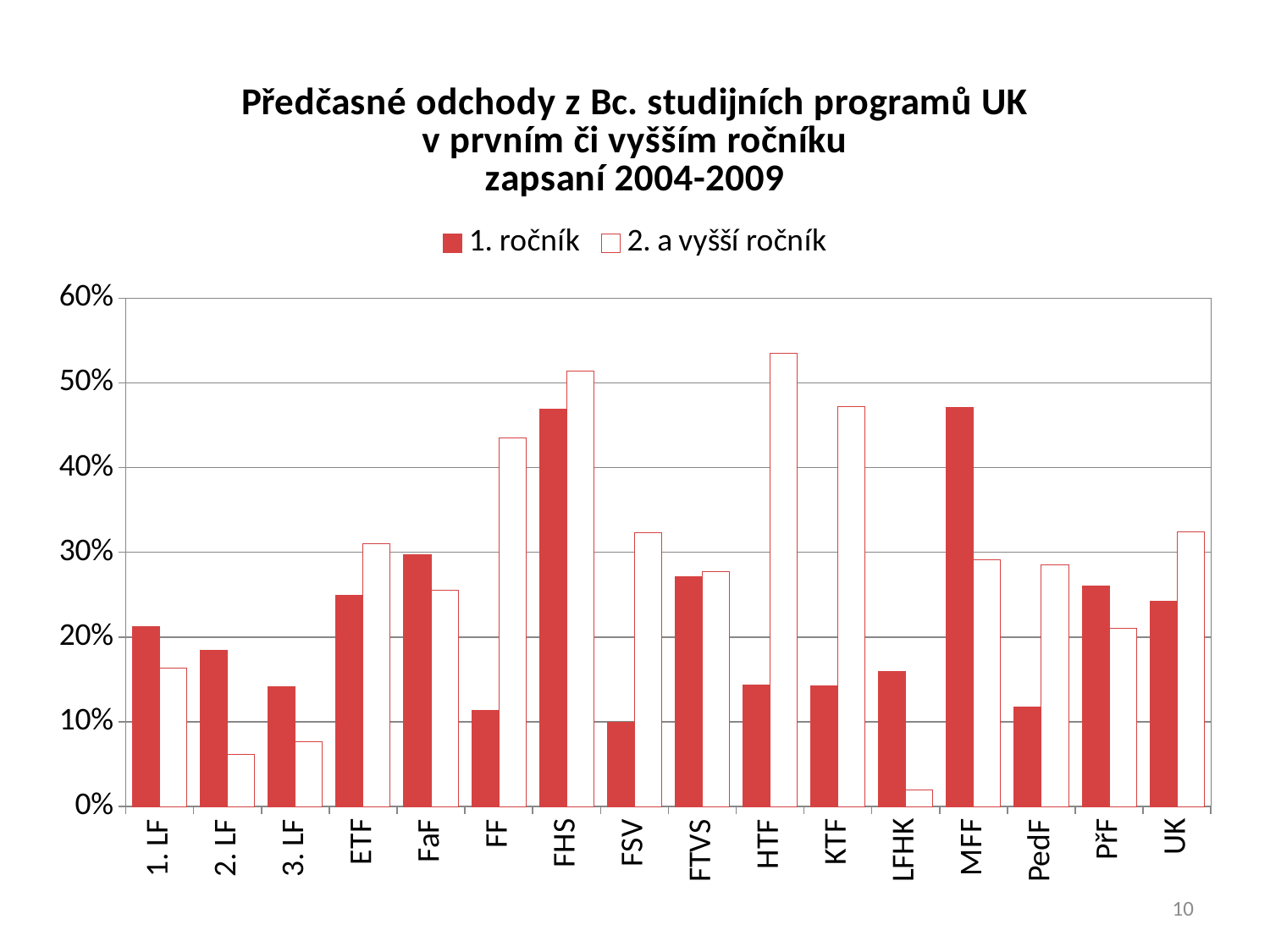
How many categories are shown on the x axis? 16 What kind of chart is shown on the slide? bar chart Is the value for LFHK in the series 2. a vyšší ročník greater or less than 10%? less What colour are the bars for the series 1. ročník? red Is the value for FF in the series 2. a vyšší ročník greater or less than 40%? greater Is the value for FHS in the series 1. ročník greater or less than 40%? greater How many series does the legend list? 2 Which category has the highest value for the series 2. a vyšší ročník? HTF Which category has the lowest value for the series 2. a vyšší ročník? LFHK For FSV, which series has the larger value: 1. ročník or 2. a vyšší ročník? 2. a vyšší ročník For MFF, which series has the larger value: 1. ročník or 2. a vyšší ročník? 1. ročník